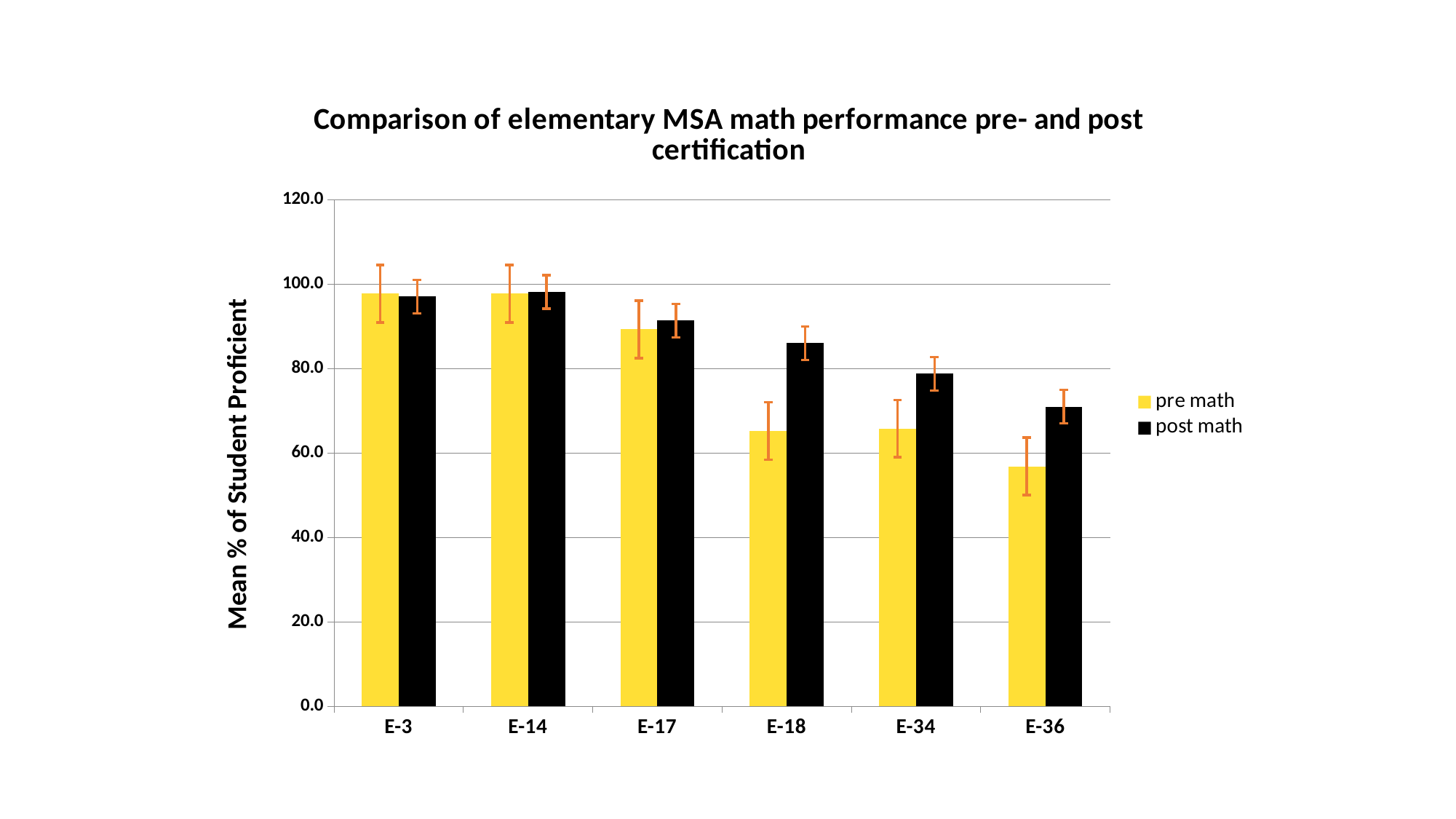
Which category has the lowest pre math value? E-36 What kind of chart is shown on the slide? bar chart Is the post math value for E-18 greater or less than 80? greater How many series does the legend list? 2 Do the pre math values generally rise or fall from E-3 to E-36 along the x axis? fall For E-36, which is larger: pre math or post math? post math What is the label of the y axis? Mean % of Student Proficient Which category has the lowest post math value? E-36 How many schools (categories) are shown on the x axis? 6 Is the pre math value for E-34 greater or less than 80? less Is the pre math value for E-36 greater or less than 60? less For E-18, which is larger: pre math or post math? post math